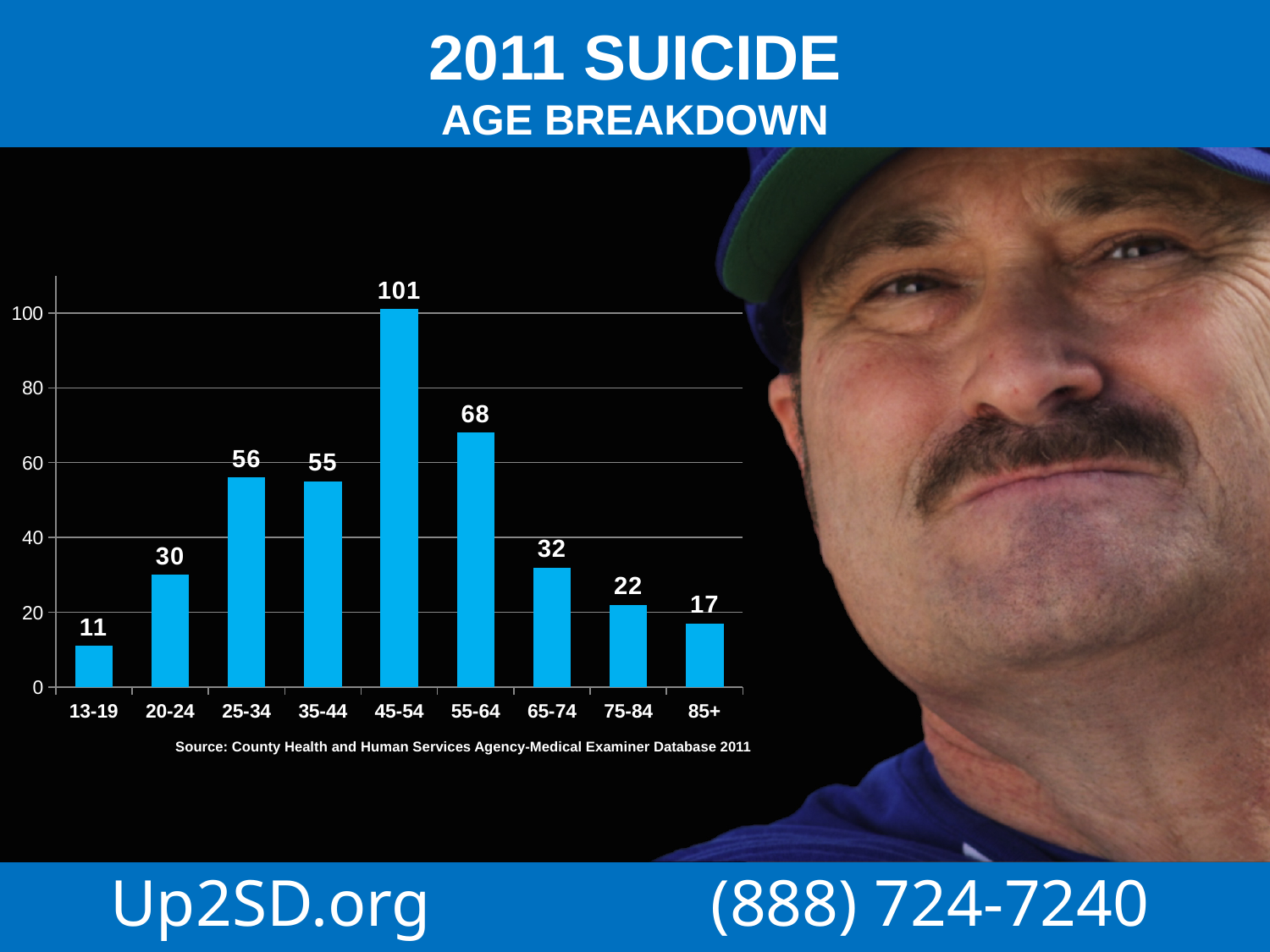
Which is larger, the value for 25-34 or the value for 65-74? 25-34 What is the value for the 13-19 age group? 11 How many age groups are shown on the chart? 9 Is the value for 55-64 greater or less than 60? greater What is the value for the 45-54 age group? 101 What kind of chart is shown on the slide? bar chart What is the value for the 65-74 age group? 32 What is the difference between the values for 20-24 and 13-19? 19 What is the source cited below the chart? County Health and Human Services Agency-Medical Examiner Database 2011 What is the difference between the values for 45-54 and 55-64? 33 Which age group has the lowest value? 13-19 Which age group has the highest value? 45-54